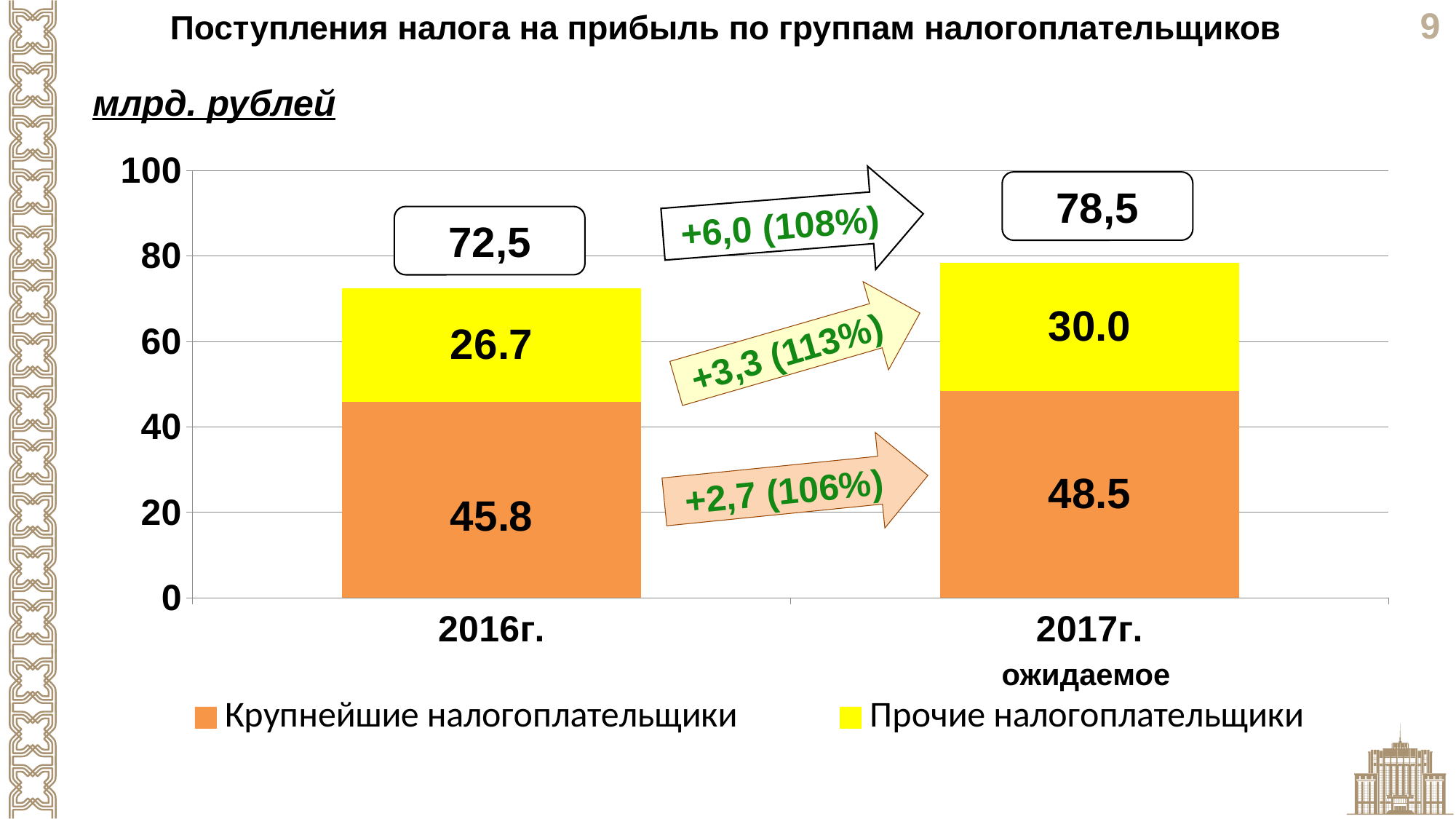
Which colour represents Прочие налогоплательщики in the legend? Yellow How many categories are shown on the x axis? 2 What is the total of the stacked bar for 2016г.? 72,5 Which category has the higher total: 2016г. or 2017г. ожидаемое? 2017г. ожидаемое How many series does the legend list? 2 What is the value for Крупнейшие налогоплательщики in 2016г.? 45.8 What is the difference between the Крупнейшие налогоплательщики values for 2017г. ожидаемое and 2016г.? 2.7 What is the total of the stacked bar for 2017г. ожидаемое? 78,5 What is the value for Прочие налогоплательщики in 2017г. ожидаемое? 30.0 What is the value for Прочие налогоплательщики in 2016г.? 26.7 What kind of chart is shown on the slide? Stacked bar chart Which is larger: Прочие налогоплательщики in 2016г. or in 2017г. ожидаемое? 2017г. ожидаемое